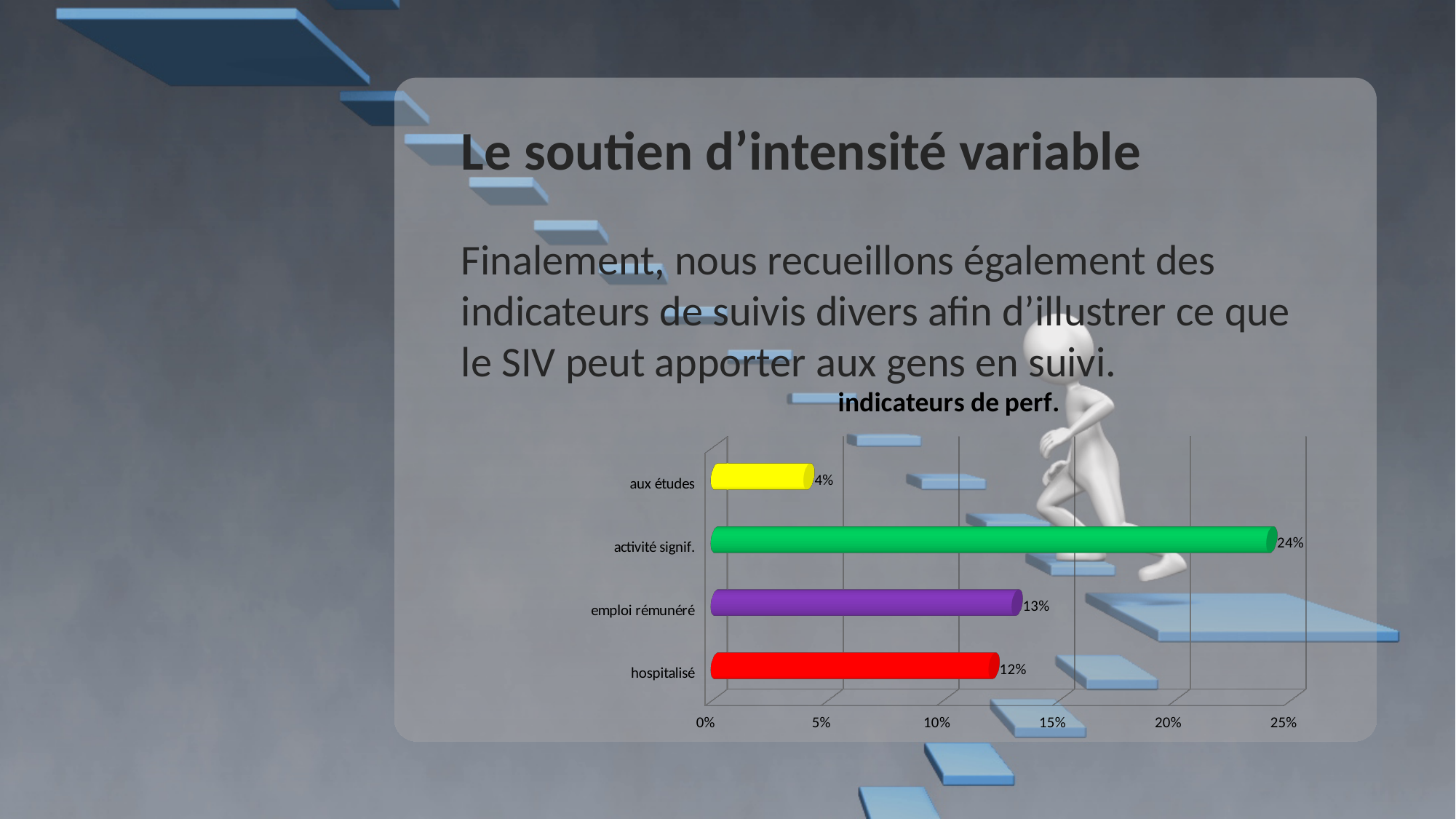
What is the value for 'hospitalisé'? 12% What kind of chart is shown on the slide? bar chart What is the difference between the values for 'activité signif.' and 'emploi rémunéré'? 11% What is the value for 'aux études'? 4% Which is larger, the value for 'emploi rémunéré' or the value for 'hospitalisé'? emploi rémunéré Is the value for 'activité signif.' greater or less than 20%? greater What is the title of the chart? indicateurs de perf. Which category has the lowest value? aux études How many categories are shown in the chart? 4 Which category has the highest value? activité signif. What is the value for 'activité signif.'? 24% What is the value for 'emploi rémunéré'? 13%